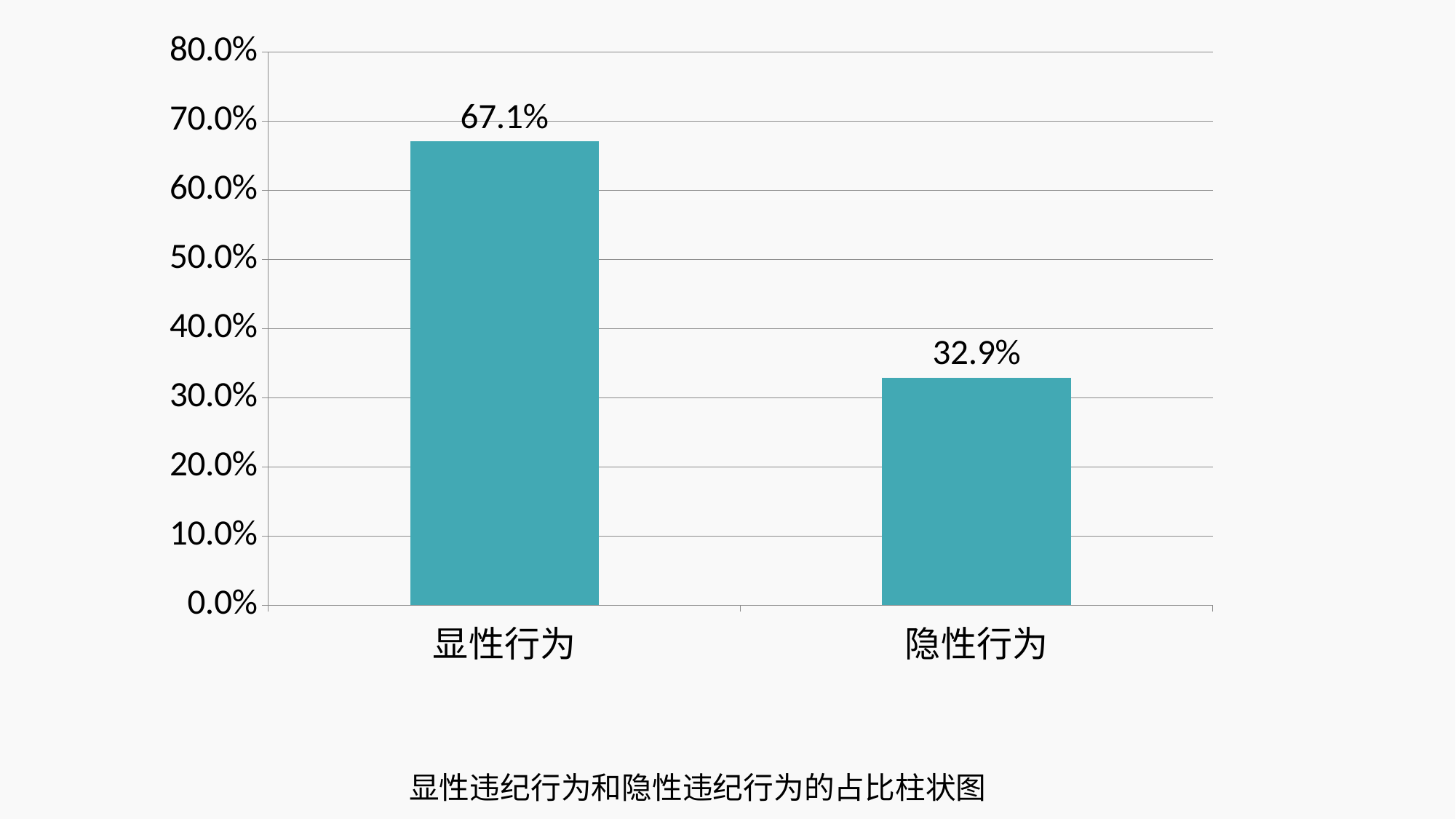
What kind of chart is shown on the slide? bar chart Is the value for 隐性行为 greater or less than 40.0%? less What is the highest value shown on the y axis? 80.0% What is the difference between the values for 显性行为 and 隐性行为? 34.2% What is the value for 隐性行为? 32.9% Which category has the highest value? 显性行为 Which is larger, the value for 显性行为 or the value for 隐性行为? 显性行为 How many categories are shown on the x axis? 2 What is the title shown below the chart? 显性违纪行为和隐性违纪行为的占比柱状图 Is the value for 显性行为 greater or less than 60.0%? greater What is the value for 显性行为? 67.1% Which category has the lowest value? 隐性行为